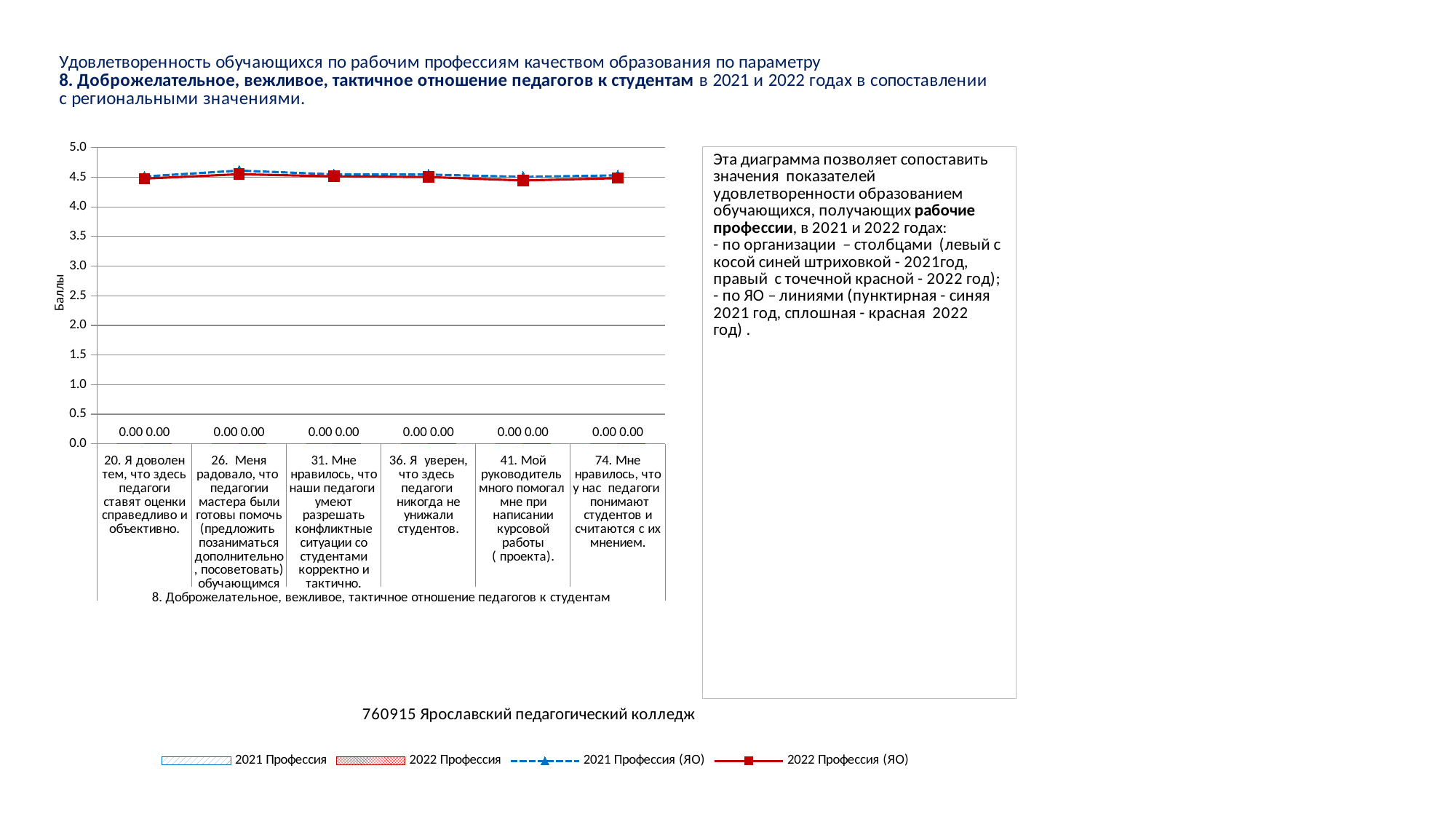
Is the value of the 2021 Профессия (ЯО) line for the category "36. Я уверен, что здесь педагоги никогда не унижали студентов." greater or less than 3.5? greater Which legend entry is drawn as a dashed blue line with triangle markers? 2021 Профессия (ЯО) What kind of chart is shown on the slide? A combined bar and line chart How many categories (questions) are shown along the x axis of the chart? 6 What is the data label printed for the 2022 Профессия bar in the category "74. Мне нравилось, что у нас педагоги понимают студентов и считаются с их мнением."? 0.00 What is the title of the vertical axis of the chart? Баллы What is the data label printed for the 2021 Профессия bar in the category "20. Я доволен тем, что здесь педагоги ставят оценки справедливо и объективно."? 0.00 Is the value of the 2021 Профессия (ЯО) line for the category "26. Меня радовало, что педагогии мастера были готовы помочь..." greater or less than 5.0? less Do the 2022 Профессия (ЯО) line values rise sharply, fall sharply, or stay roughly flat across the categories? Stay roughly flat Is the value of the 2022 Профессия (ЯО) line for the category "41. Мой руководитель много помогал мне при написании курсовой работы ( проекта)." greater or less than 4.0? greater How many series does the chart legend list? 4 What is the highest value shown on the vertical axis of the chart? 5.0